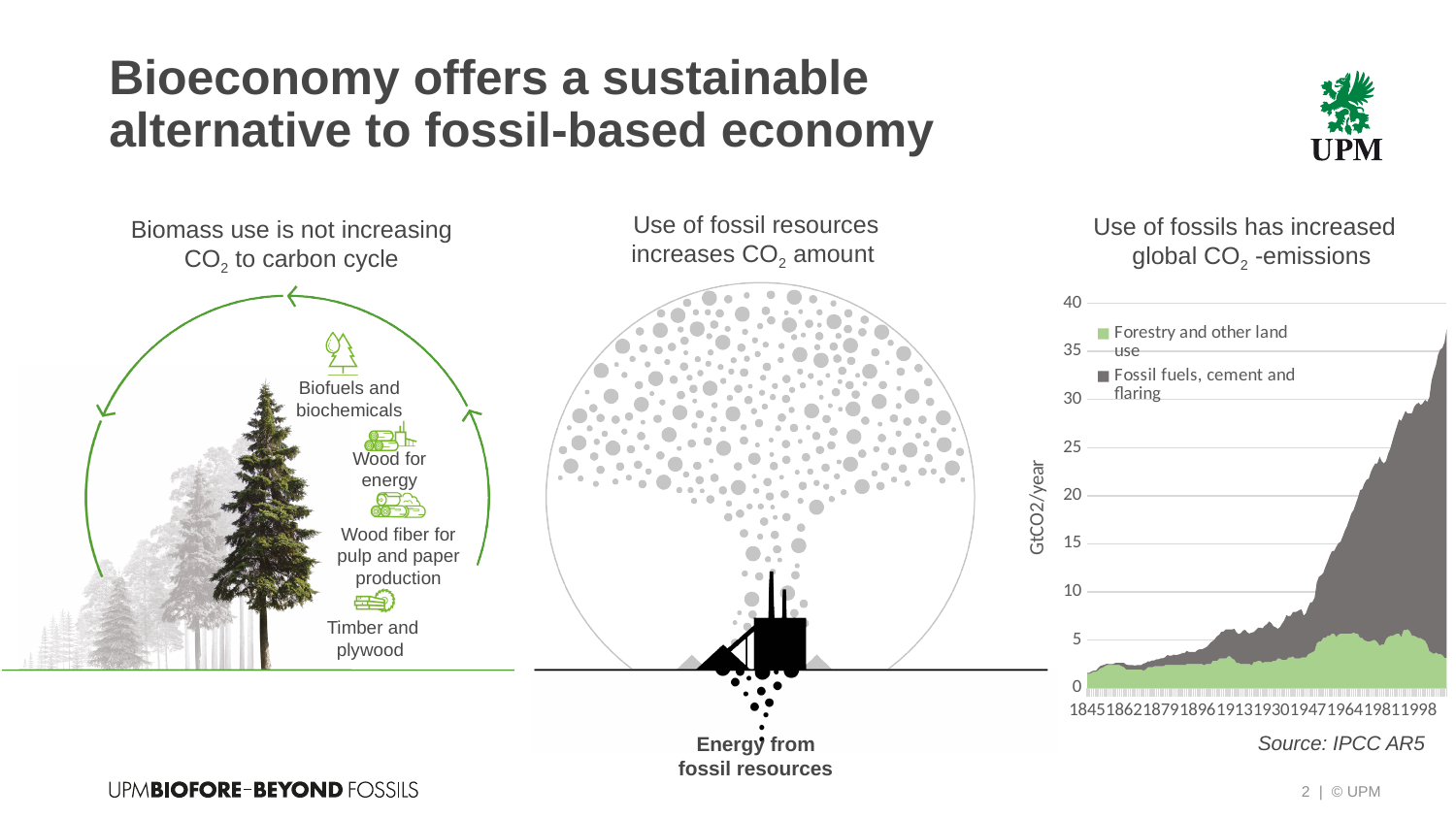
Is the total emissions value around 1930 greater or less than 10? less Do total emissions in the chart rise or fall from 1845 to 1998? Rise What are the two series listed in the chart's legend? Forestry and other land use; Fossil fuels, cement and flaring Which series contributes more emissions at the right end of the chart (around 1998): Forestry and other land use, or Fossil fuels, cement and flaring? Fossil fuels, cement and flaring What is the first year shown on the chart's horizontal axis? 1845 Which series contributes more emissions at the left end of the chart (around 1845): Forestry and other land use, or Fossil fuels, cement and flaring? Forestry and other land use What is the highest value shown on the chart's vertical axis? 40 Is the total emissions value at the left end of the chart (around 1845) greater or less than 5? less What is the label on the chart's vertical axis? GtCO2/year How many series does the chart's legend list? 2 What kind of chart is shown on the slide? Stacked area chart Is the total emissions value at the right end of the chart (around 1998) greater or less than 25? greater